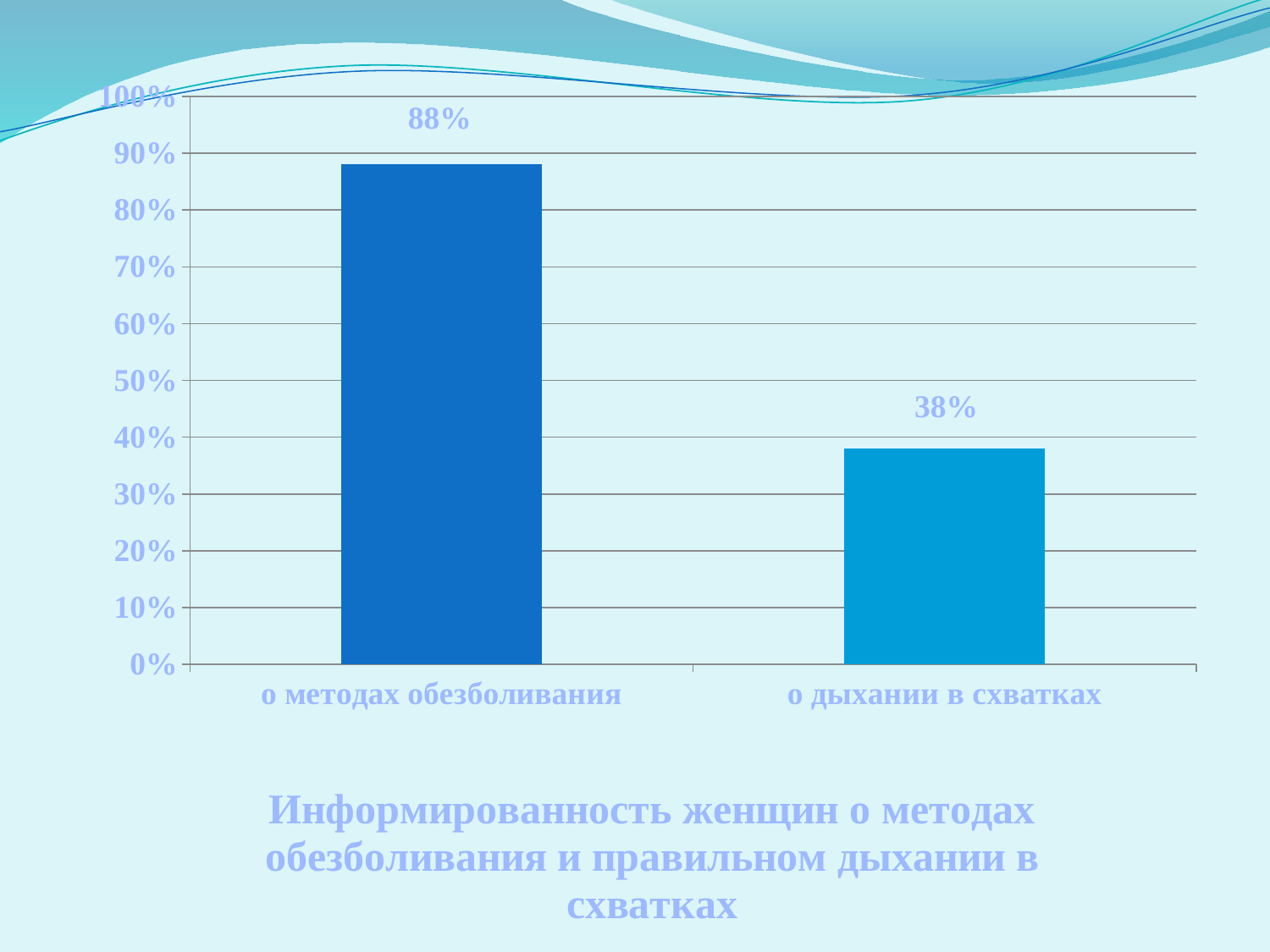
What is the highest value shown on the vertical axis? 100% How many categories are shown on the chart? 2 What is the difference between the values for "о методах обезболивания" and "о дыхании в схватках"? 50% What is the value for "о методах обезболивания"? 88% Is the value for "о методах обезболивания" greater or less than 80%? greater Which category has the lowest value? о дыхании в схватках What is the title of the chart? Информированность женщин о методах обезболивания и правильном дыхании в схватках What is the value for "о дыхании в схватках"? 38% What kind of chart is shown on the slide? bar chart Which is larger: the value for "о методах обезболивания" or for "о дыхании в схватках"? о методах обезболивания Which category has the highest value? о методах обезболивания Is the value for "о дыхании в схватках" greater or less than 50%? less